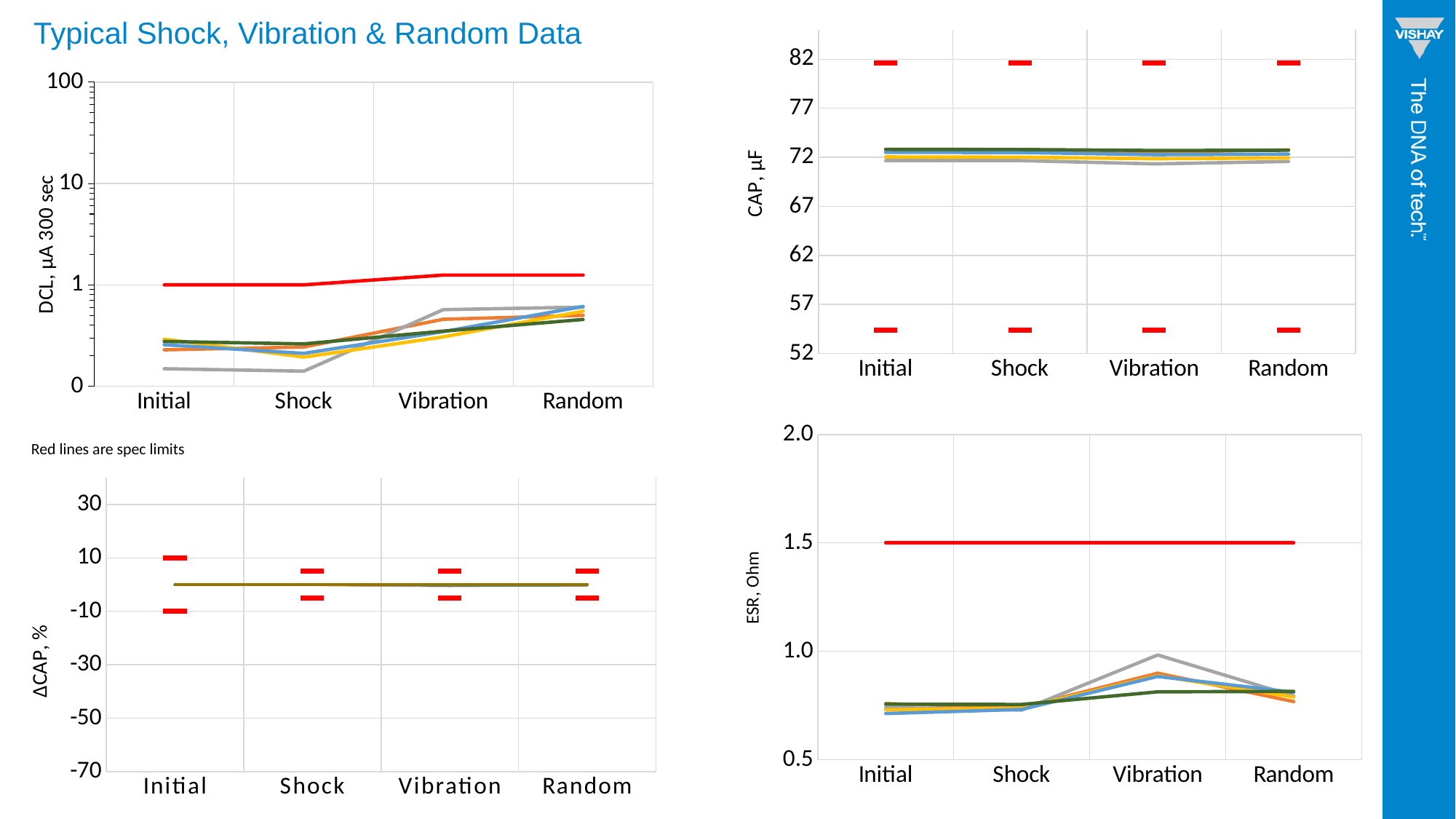
In the CAP chart at the top right, is the upper red spec limit greater or less than 77? greater In the DCL chart at the top left, do the plotted sample lines rise or fall from Shock to Random? rise In the ΔCAP chart at the bottom left, what is the lower red spec limit at Initial? -10 How many categories are shown on the x axis of the ESR chart at the bottom right? 4 In the DCL chart at the top left, what value does the red spec limit line have at Initial? 1 In the ESR chart at the bottom right, at what value does the red spec limit line sit? 1.5 According to the note on the slide, what do the red lines represent? spec limits In the ESR chart at the bottom right, is the gray line's value at Vibration greater or less than 0.5? greater In the ΔCAP chart at the bottom left, what is the upper red spec limit at Initial? 10 In the ESR chart at the bottom right, is the gray line's value larger at Initial or at Vibration? Vibration What kind of chart is the DCL chart at the top left of the slide? line chart In the CAP chart at the top right, is the lower red spec limit greater or less than 57? less